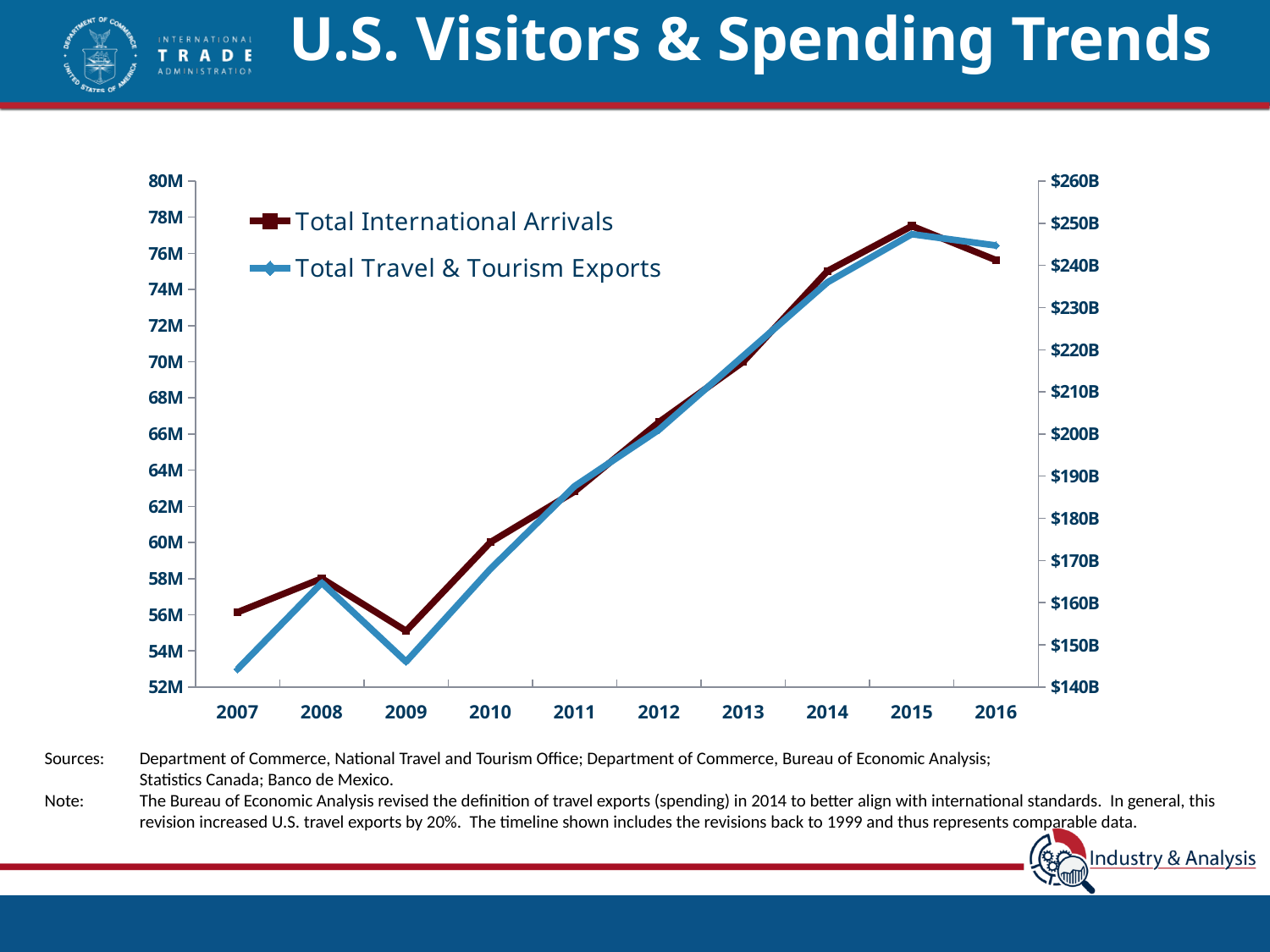
How many years are plotted along the x axis? 10 How many series does the legend list? 2 Which is larger for Total International Arrivals: 2008 or 2009? 2008 Do Total International Arrivals rise or fall from 2009 to 2015? rise In which year is Total International Arrivals lowest? 2009 What colour is the Total Travel & Tourism Exports line? blue What kind of chart is shown on the slide? line chart Is the value for Total International Arrivals in 2014 greater or less than 74M? greater In which year is Total International Arrivals highest? 2015 In which year is Total Travel & Tourism Exports highest? 2015 Is the value for Total Travel & Tourism Exports in 2012 greater or less than $190B? greater Is the value for Total International Arrivals in 2009 greater or less than 56M? less